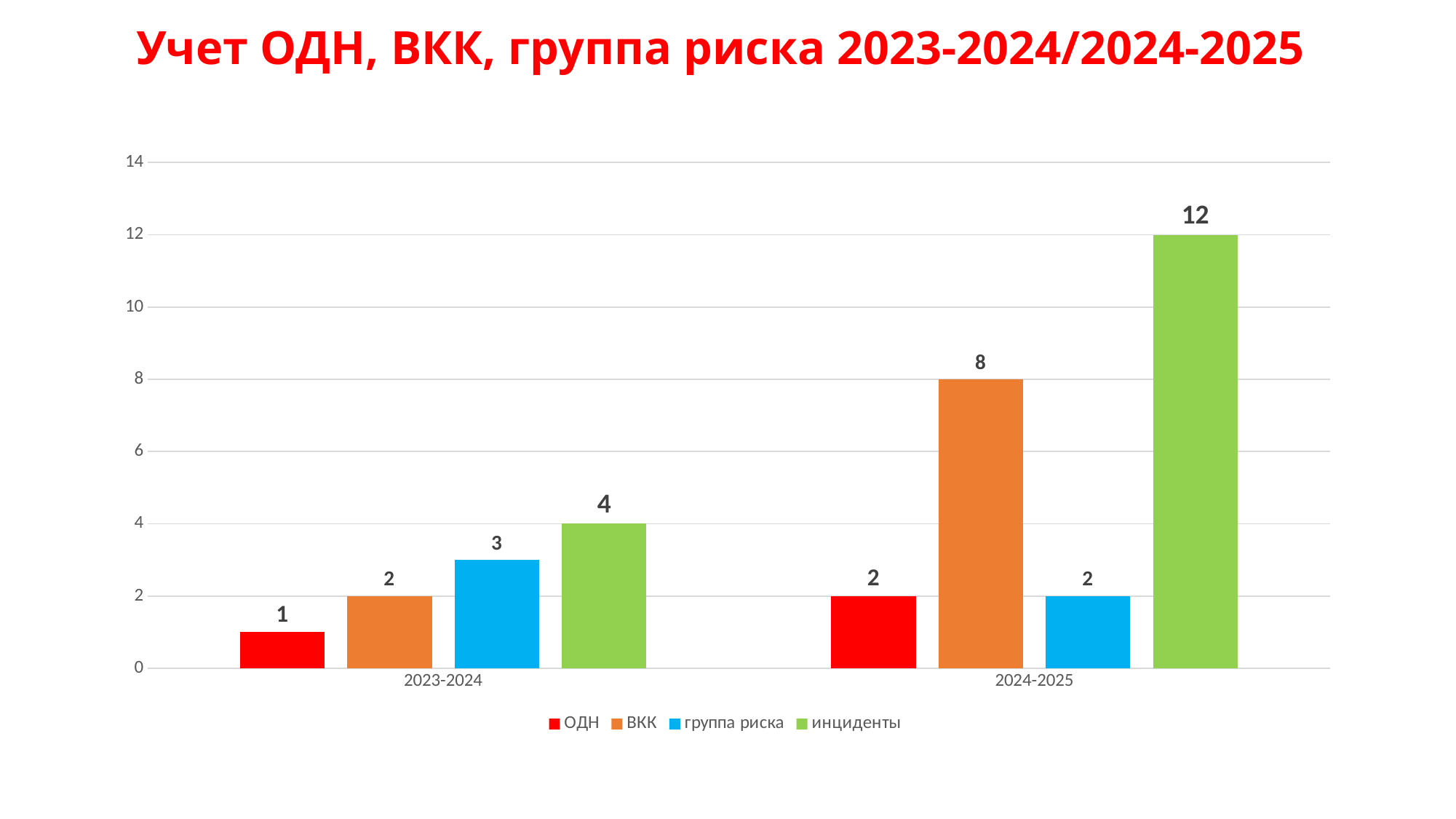
What is the value for ВКК in 2024-2025? 8 What is the value for ОДН in 2023-2024? 1 What kind of chart is shown on the slide? bar chart What colour are the bars for инциденты? green What is the value for группа риска in 2023-2024? 3 Which series has the highest value in 2024-2025? инциденты What is the value for инциденты in 2024-2025? 12 How many categories are shown on the x axis? 2 What is the difference between инциденты in 2024-2025 and инциденты in 2023-2024? 8 How many series does the legend list? 4 Which series has the lowest value in 2023-2024? ОДН Which is larger: ВКК in 2024-2025 or группа риска in 2024-2025? ВКК in 2024-2025